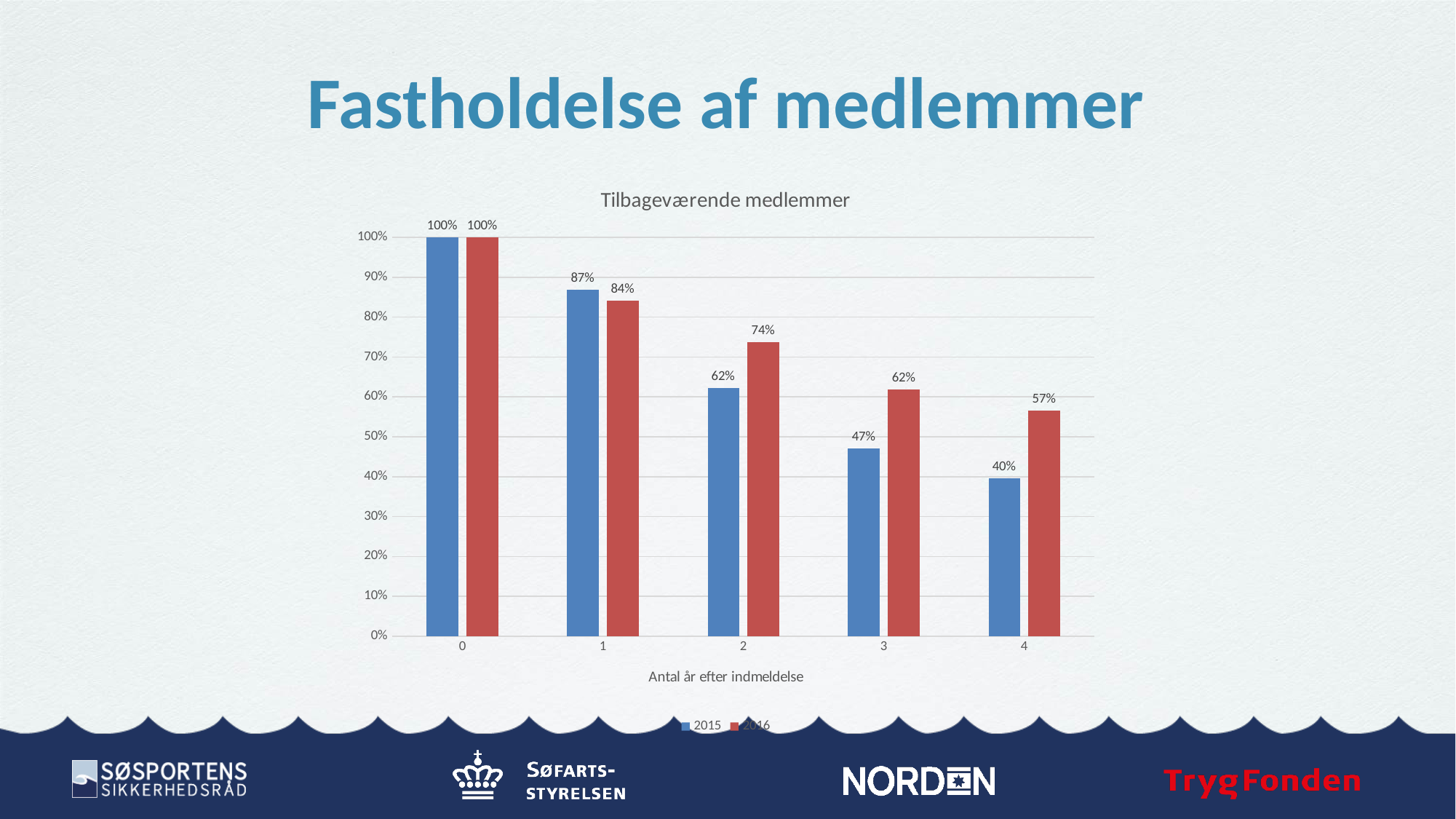
How many series does the legend list? 2 At which number of years after enrolment is the 2015 value lowest? 4 How many categories are shown on the x axis? 5 What is the value for 2015 at 2 years after enrolment (Antal år efter indmeldelse = 2)? 62% What kind of chart is shown on the slide? Bar chart What is the value for 2015 at 3 years after enrolment? 47% What is the difference between the 2016 and 2015 values at 4 years after enrolment? 17% What is the difference between the 2015 and 2016 values at 1 year after enrolment? 3% Which series has the larger value at 3 years after enrolment, 2015 or 2016? 2016 What is the value for 2016 at 4 years after enrolment? 57% Do the 2015 values rise or fall as the number of years after enrolment increases? Fall What is the value for 2016 at 1 year after enrolment? 84%